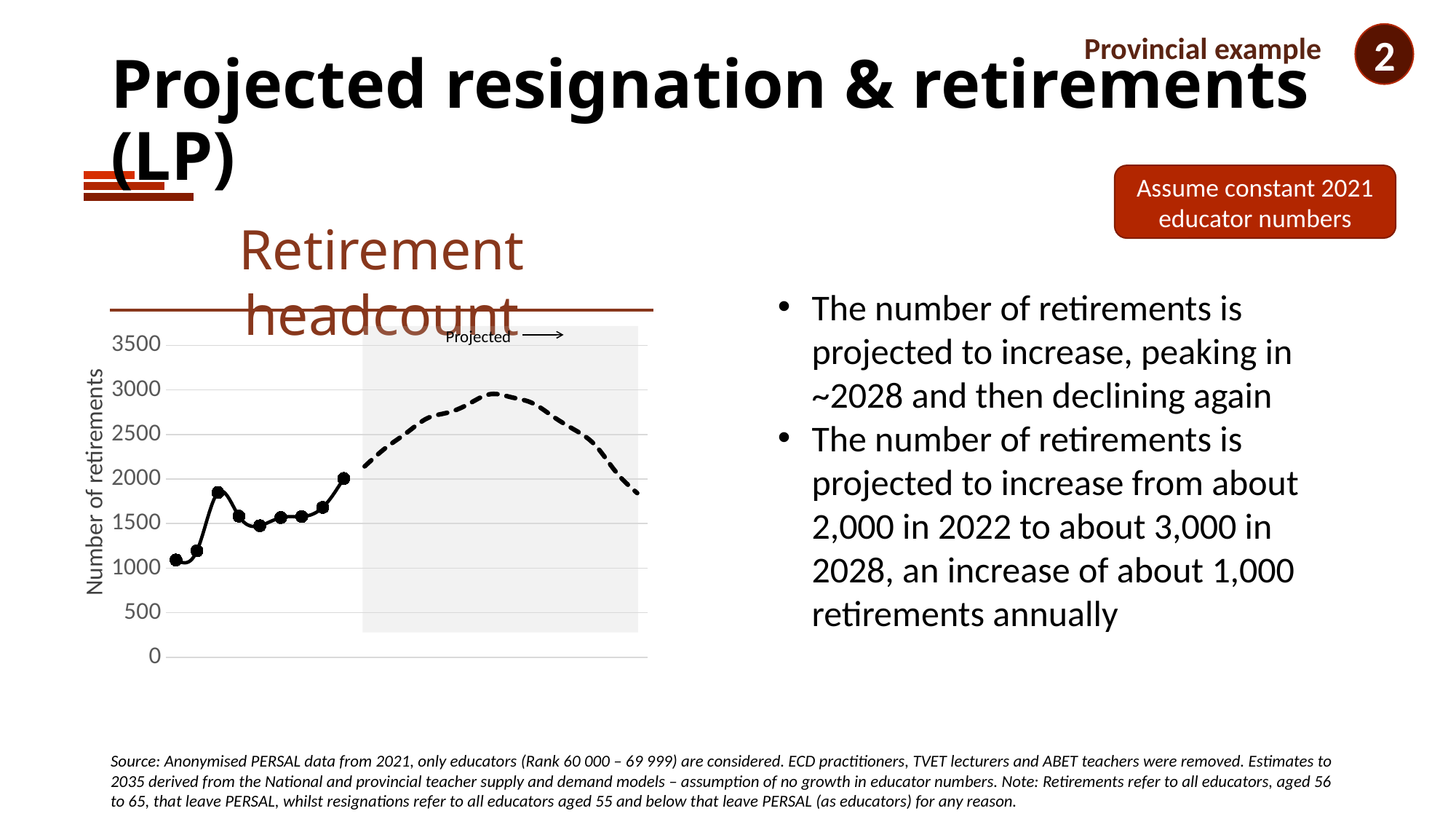
In the shaded projected region of the Retirement headcount chart, does the line rise throughout, fall throughout, or rise and then fall? rise and then fall What kind of chart is the Retirement headcount chart? line chart Is the first marked point on the solid line in the Retirement headcount chart greater or less than 1500? less Is the final point of the dashed projected line in the Retirement headcount chart greater or less than 2500? less What is the label on the vertical axis of the Retirement headcount chart? Number of retirements Is the highest point of the dashed projected line in the Retirement headcount chart greater or less than 2500? greater What is the title of the chart on the slide? Retirement headcount How many data points are marked on the solid (actual) part of the line in the Retirement headcount chart? 9 What is the highest tick value shown on the vertical axis of the Retirement headcount chart? 3500 Comparing the first and last marked points of the solid line in the Retirement headcount chart, which is higher? the last point